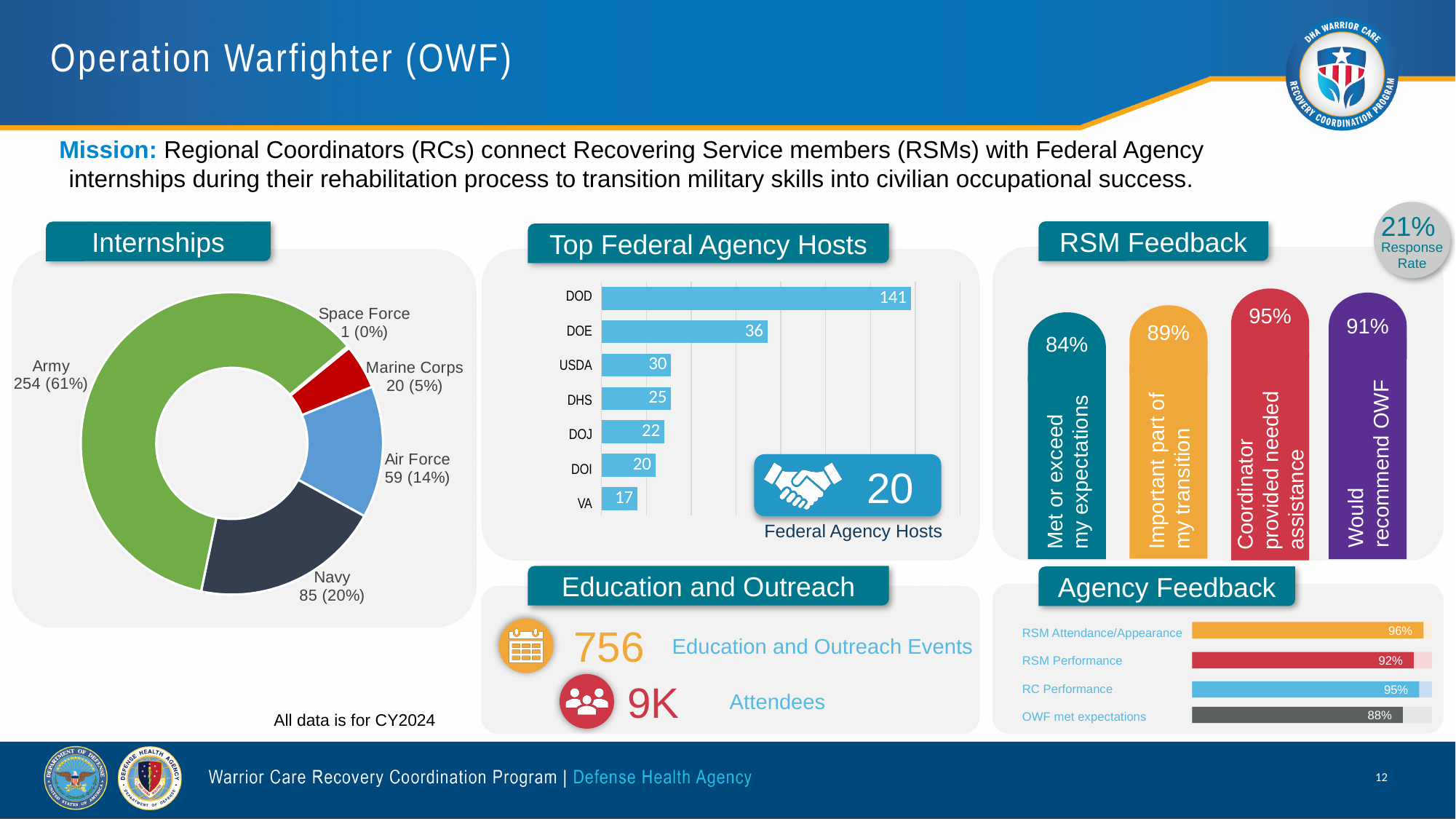
In the Internships chart, which branch has the fewest internships? Space Force What kind of chart is the Internships chart? Donut (pie) chart In the Agency Feedback chart, which item has the lowest percentage? OWF met expectations In the Internships chart, how many branches are shown? 5 In the Top Federal Agency Hosts chart, what is the difference between DOD and DOE? 105 In the Top Federal Agency Hosts chart, which is larger, USDA or DHS? USDA In the RSM Feedback chart, what percentage said the coordinator provided needed assistance? 95% In the Top Federal Agency Hosts chart, how many agencies are listed? 7 In the Top Federal Agency Hosts chart, which agency has the highest value? DOD In the Top Federal Agency Hosts chart, what is the value for DOE? 36 In the Internships chart, what share of internships does Navy represent? 20% In the Internships chart, how many internships does Army account for? 254 (61%)